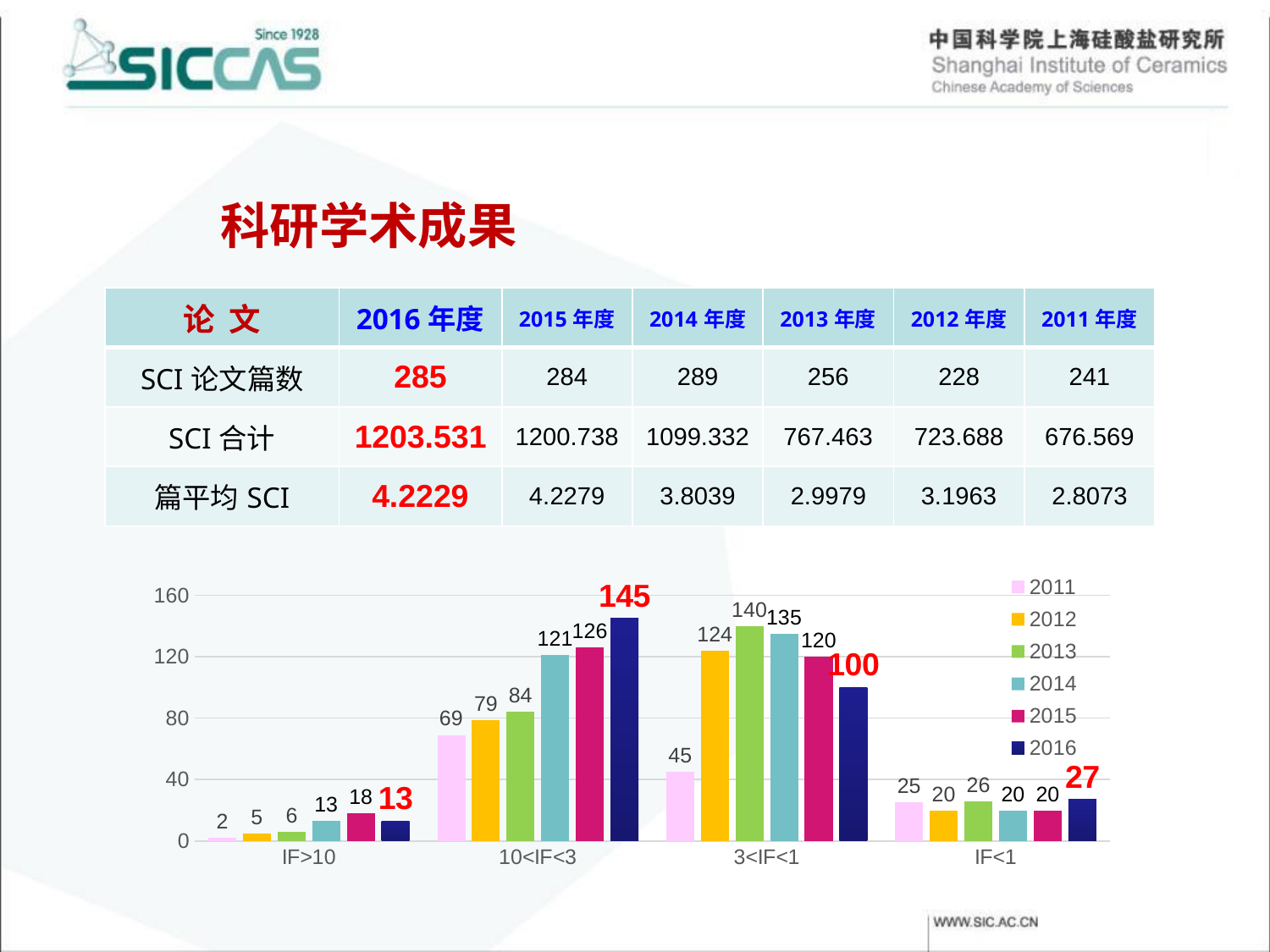
Which year has the highest value in the 3<IF<1 category? 2013 What is the value for 2013 in the 3<IF<1 category? 140 What type of chart is shown on the slide? bar chart What is the value for 2016 in the 10<IF<3 category? 145 Which is larger in the IF<1 category, the value for 2016 or the value for 2013? 2016 How many series does the chart legend list? 6 Do the values for the 10<IF<3 category rise or fall from 2011 to 2016? rise Which year has the lowest value in the 10<IF<3 category? 2011 What is the difference between the 2016 and 2015 values in the 10<IF<3 category? 19 How many categories are shown on the x axis of the chart? 4 What is the value for 2011 in the IF>10 category? 2 Which colour represents the 2016 series in the chart legend? dark blue